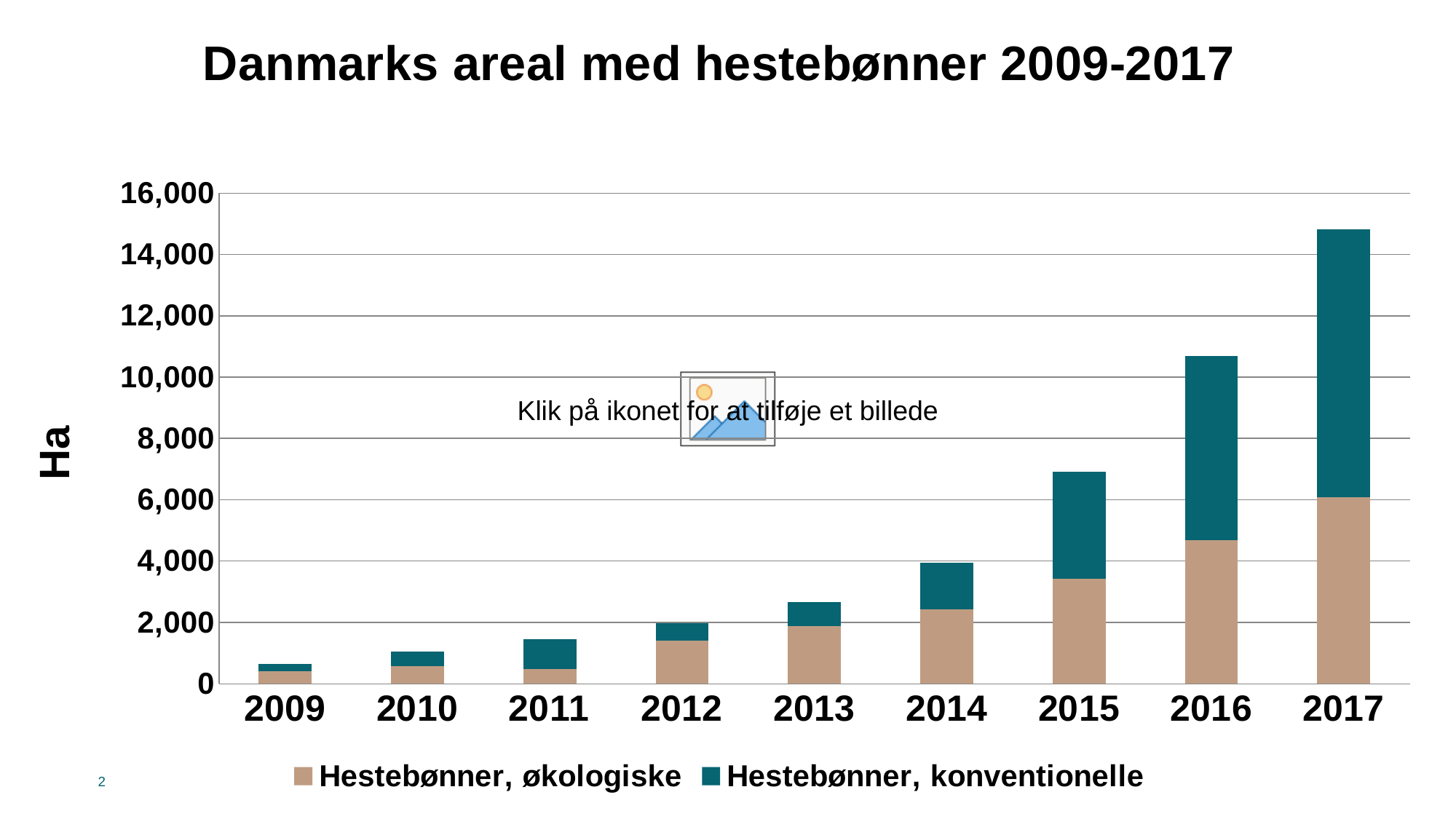
How many series does the chart's legend list? 2 How many years are shown on the x axis of the chart? 9 Is the value for Hestebønner, økologiske in 2017 greater or less than 4,000? greater Is the total area for 2009 greater or less than 2,000? less Is the total area for 2017 greater or less than 14,000? greater Which year has the lowest total area of hestebønner? 2009 Which year has the highest total area of hestebønner? 2017 Which year has the larger total area, 2015 or 2016? 2016 What kind of chart is shown on the slide? bar chart Do the total areas rise or fall from 2009 to 2017? rise